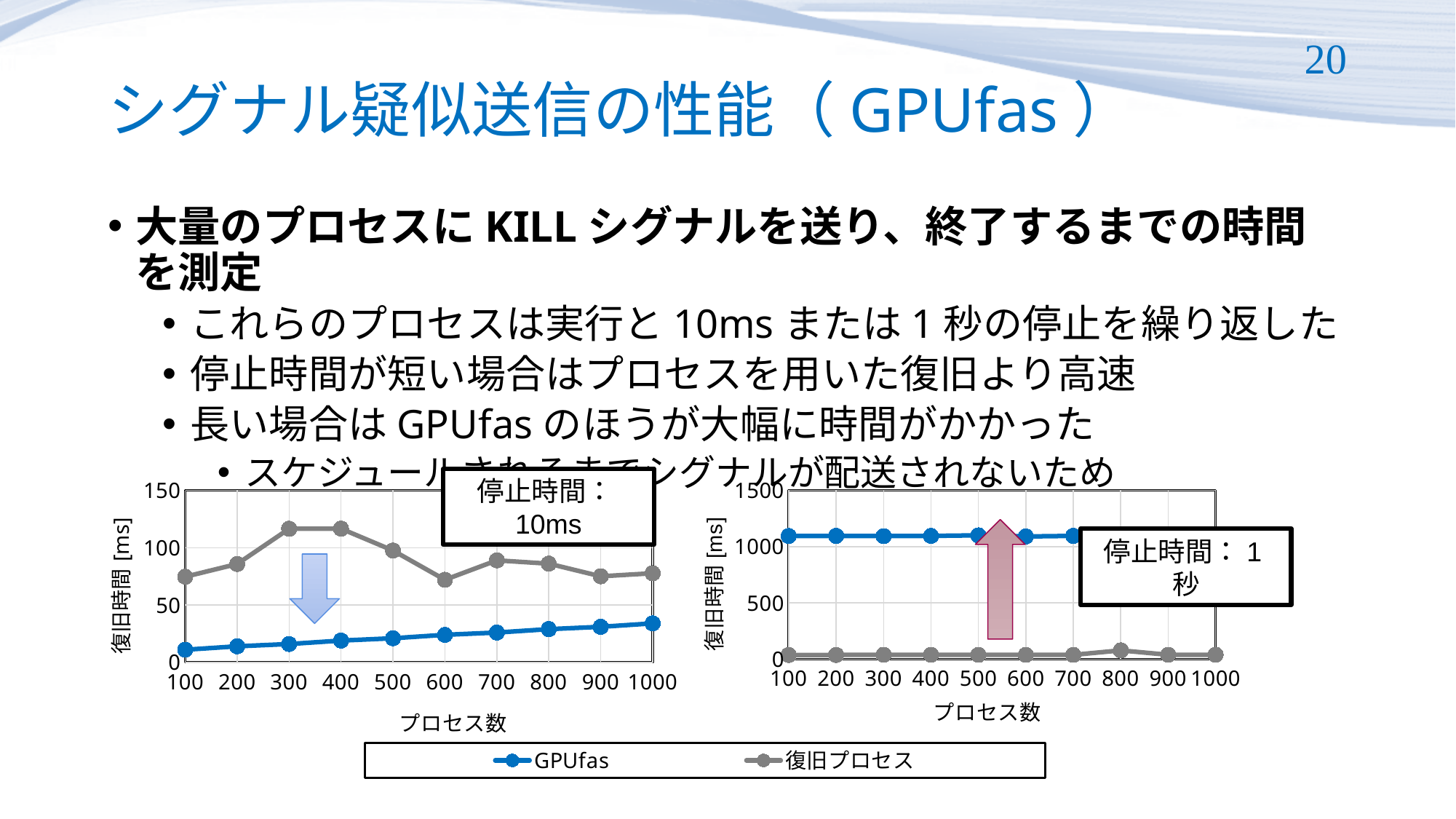
In the right chart (停止時間: 1秒), is the GPUfas value at 500 processes greater or less than 1000? greater In the left chart (停止時間: 10ms), at which プロセス数 is the GPUfas value highest? 1000 In the left chart (停止時間: 10ms), at which プロセス数 is the GPUfas value lowest? 100 In the right chart (停止時間: 1秒), at 500 processes, which series has the larger value, GPUfas or 復旧プロセス? GPUfas What is the x-axis label of the right chart (停止時間: 1秒)? プロセス数 In the left chart (停止時間: 10ms), at 500 processes, which series has the larger value, GPUfas or 復旧プロセス? 復旧プロセス In the left chart (停止時間: 10ms), does the GPUfas series rise or fall as プロセス数 increases? rise How many series does the legend list? 2 In the left chart (停止時間: 10ms), how many data points does the GPUfas series have? 10 What kind of chart is the left chart (停止時間: 10ms)? line chart In the left chart (停止時間: 10ms), is the GPUfas value at 1000 processes greater or less than 50? less In the left chart (停止時間: 10ms), is the 復旧プロセス value at 300 processes greater or less than 100? greater